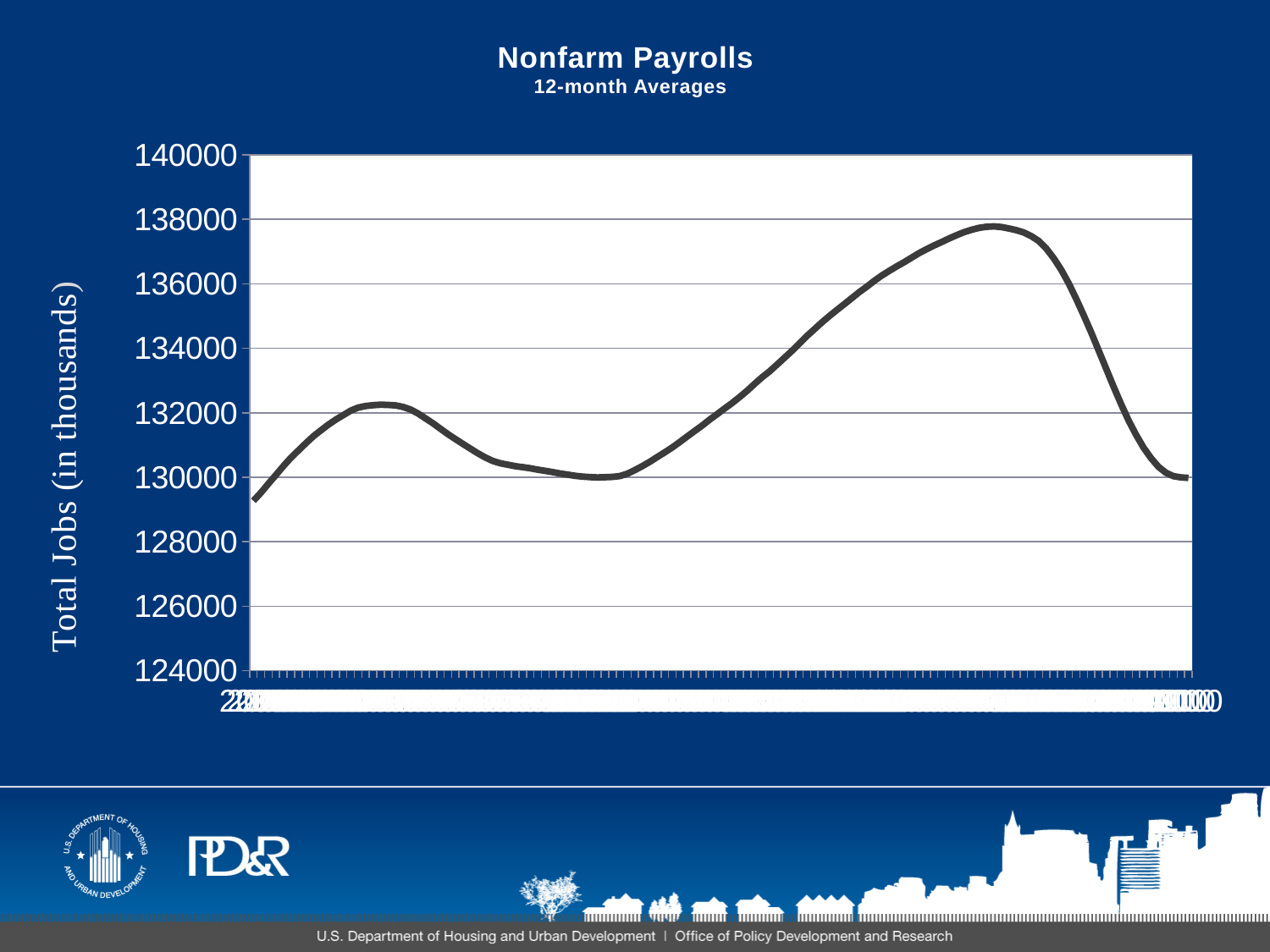
Is the value at the right end of the line greater or less than 134000? less What kind of chart is shown on the slide? line chart What is the label on the vertical axis of the chart? Total Jobs (in thousands) Does the line rise or fall at the very start of the chart? rise How many lines are plotted on the chart? 1 Does the line rise or fall from its highest peak to the right end of the chart? fall Which is higher, the first peak of the line or the second peak? the second peak Is the value at the left end of the line greater or less than 132000? less Is the highest point of the line greater or less than 136000? greater What is the title of the chart? Nonfarm Payrolls